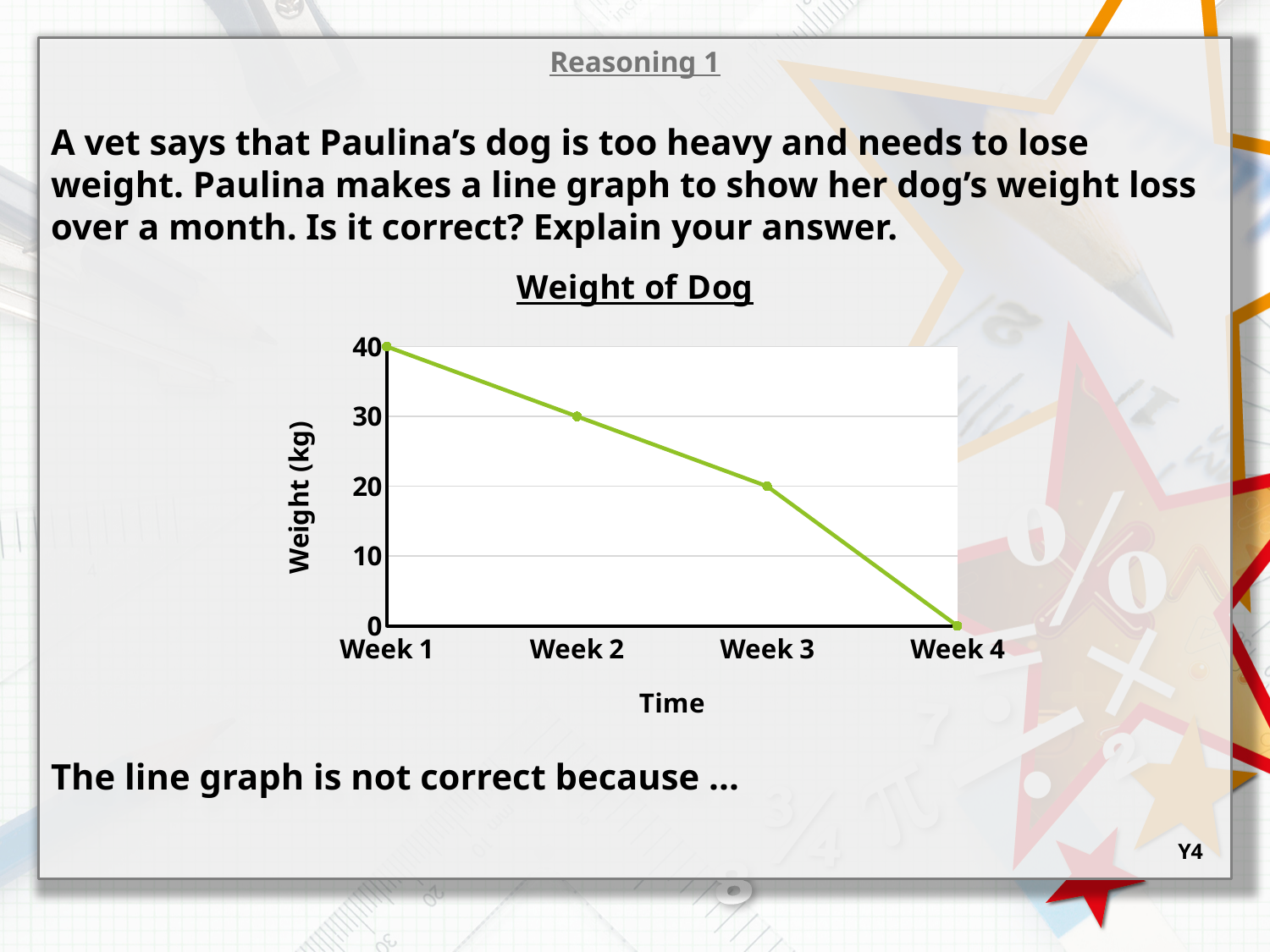
Does the dog's weight rise or fall from Week 1 to Week 4? Fall What is the weight of the dog in Week 2? 30 kg What is the weight of the dog in Week 4? 0 kg In which week is the dog's weight highest? Week 1 What kind of chart is shown on the slide? Line chart Which is larger, the weight in Week 2 or the weight in Week 4? Week 2 What is the difference in weight between Week 1 and Week 3? 20 kg What is the weight of the dog in Week 1? 40 kg What is the title of the chart? Weight of Dog How many weeks are plotted on the chart? 4 What is the weight of the dog in Week 3? 20 kg In which week is the dog's weight lowest? Week 4